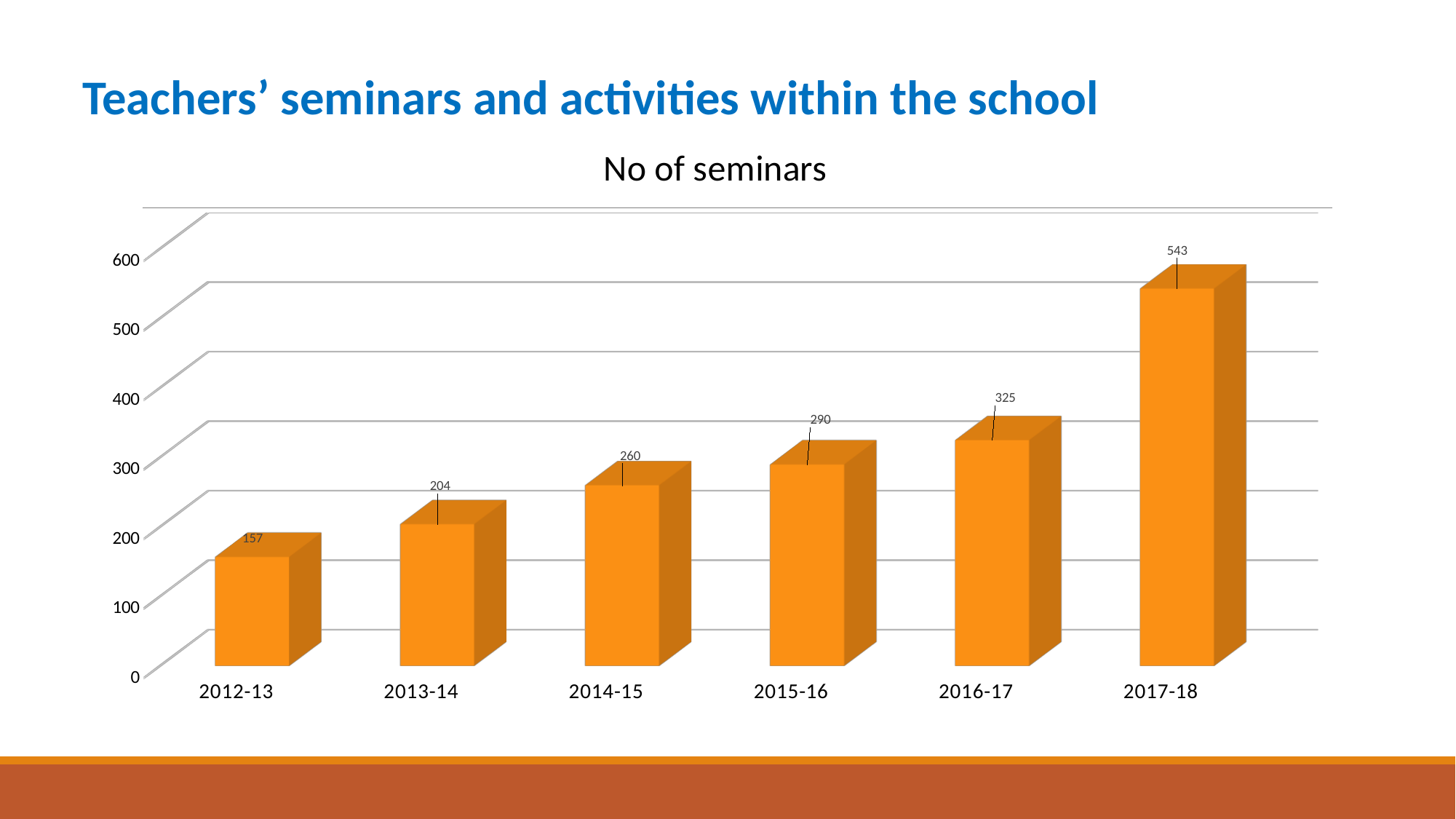
What is the number of seminars for 2012-13? 157 Which year has more seminars, 2013-14 or 2015-16? 2015-16 What is the number of seminars for 2017-18? 543 Is the value for 2016-17 greater or less than 300? greater Which year has the lowest number of seminars? 2012-13 Which year has the highest number of seminars? 2017-18 What is the number of seminars for 2015-16? 290 What kind of chart is shown on the slide? Bar chart How many years are shown on the x axis of the chart? 6 What is the difference in the number of seminars between 2014-15 and 2013-14? 56 What is the difference in the number of seminars between 2017-18 and 2016-17? 218 Do the number of seminars rise or fall from 2012-13 to 2017-18? Rise